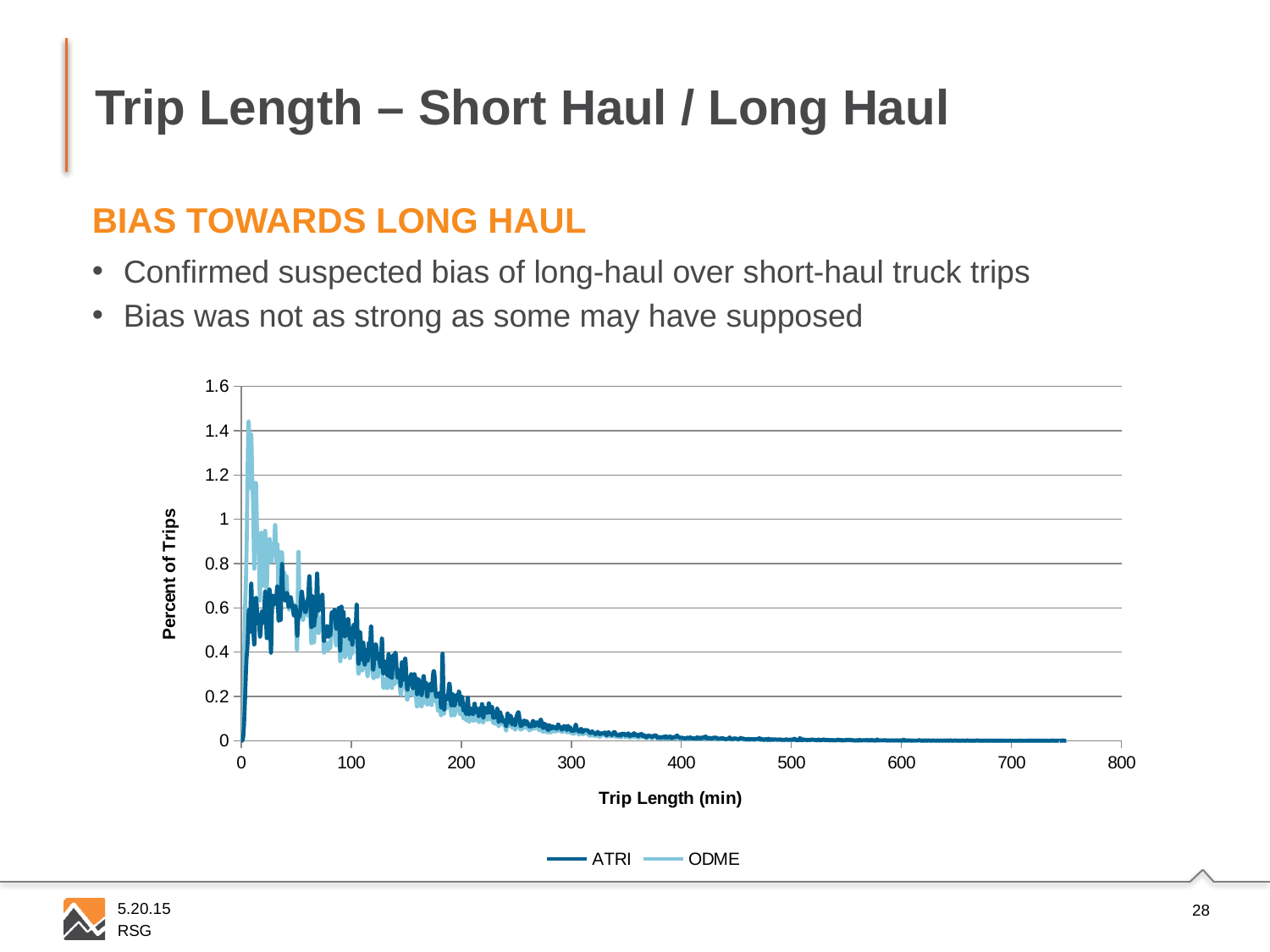
Is the peak value of the ODME series greater or less than 1.2? greater Is the value of the ODME series at a trip length of 400 minutes greater or less than 0.4? less Which series reaches the higher peak value, ATRI or ODME? ODME Is the peak value of the ATRI series greater or less than 1? less What kind of chart is shown on the slide? line chart What is the highest value shown on the chart's y axis? 1.6 What is the title of the chart's x axis? Trip Length (min) Beyond the initial peak, do the values of the series rise or fall as trip length increases along the x axis? fall How many series does the chart's legend list? 2 What are the two series named in the chart's legend? ATRI and ODME